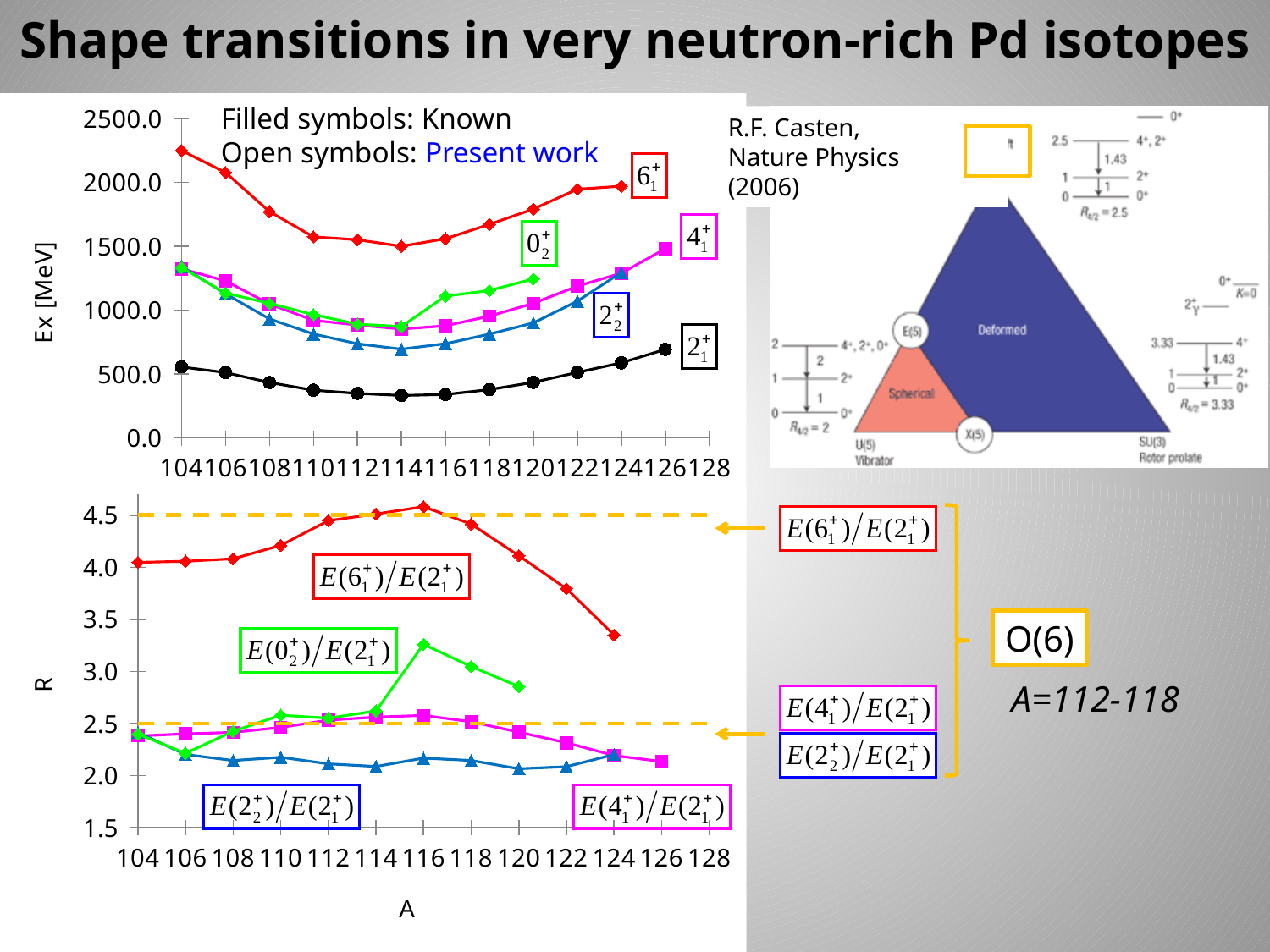
In the top chart (Ex [MeV] versus A), which labelled series has the lowest excitation energies? 2₁⁺ How many series are plotted in the bottom chart (R versus A)? 6 In the bottom chart (R versus A), is the E(6₁⁺)/E(2₁⁺) value at A=124 greater or less than 3.5? less In the bottom chart (R versus A), does the E(6₁⁺)/E(2₁⁺) series rise or fall from A=118 to A=124? fall What kind of chart is the top chart (Ex [MeV] versus A)? line chart In the top chart (Ex [MeV] versus A), is the 6₁⁺ value at A=104 greater or less than 2000.0? greater In the top chart (Ex [MeV] versus A), which labelled series has the highest excitation energies? 6₁⁺ In the bottom chart (R versus A), is the E(0₂⁺)/E(2₁⁺) value at A=116 greater or less than 3.0? greater In the top chart (Ex [MeV] versus A), does the 2₁⁺ series rise or fall from A=104 to A=114? fall What is the y-axis label of the top chart? Ex [MeV]